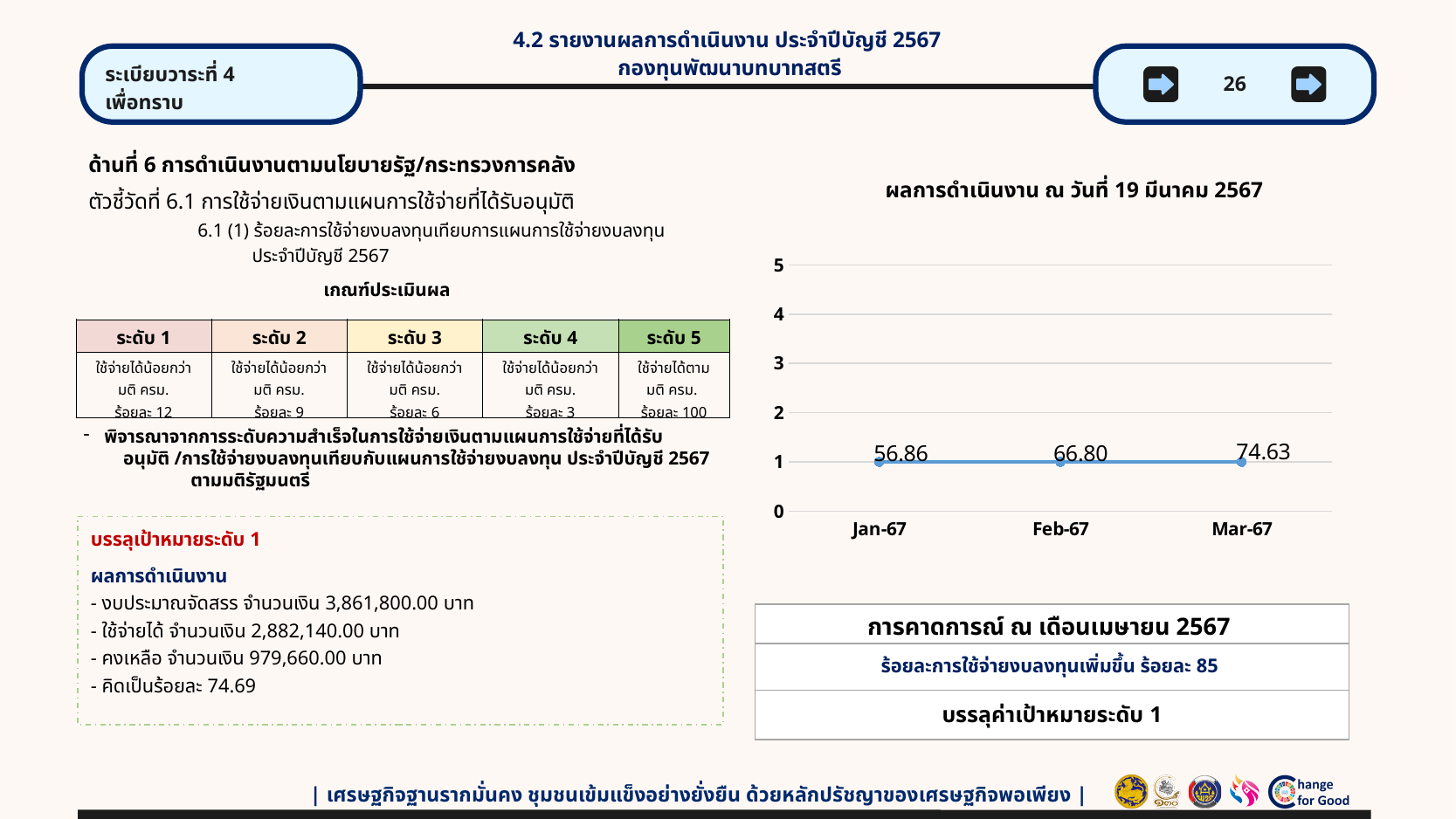
What is the title of the chart? ผลการดำเนินงาน ณ วันที่ 19 มีนาคม 2567 Which is larger, the data label for Feb-67 or for Mar-67? Mar-67 Do the data label values rise or fall from Jan-67 to Mar-67? rise Which month has the lowest data label value? Jan-67 Which month has the highest data label value? Mar-67 What is the data label shown for Jan-67? 56.86 How many months are plotted on the x axis? 3 What is the difference between the data labels for Feb-67 and Jan-67? 9.94 What is the data label shown for Mar-67? 74.63 What type of chart is shown on the slide? line chart What is the data label shown for Feb-67? 66.80 What is the difference between the data labels for Mar-67 and Jan-67? 17.77